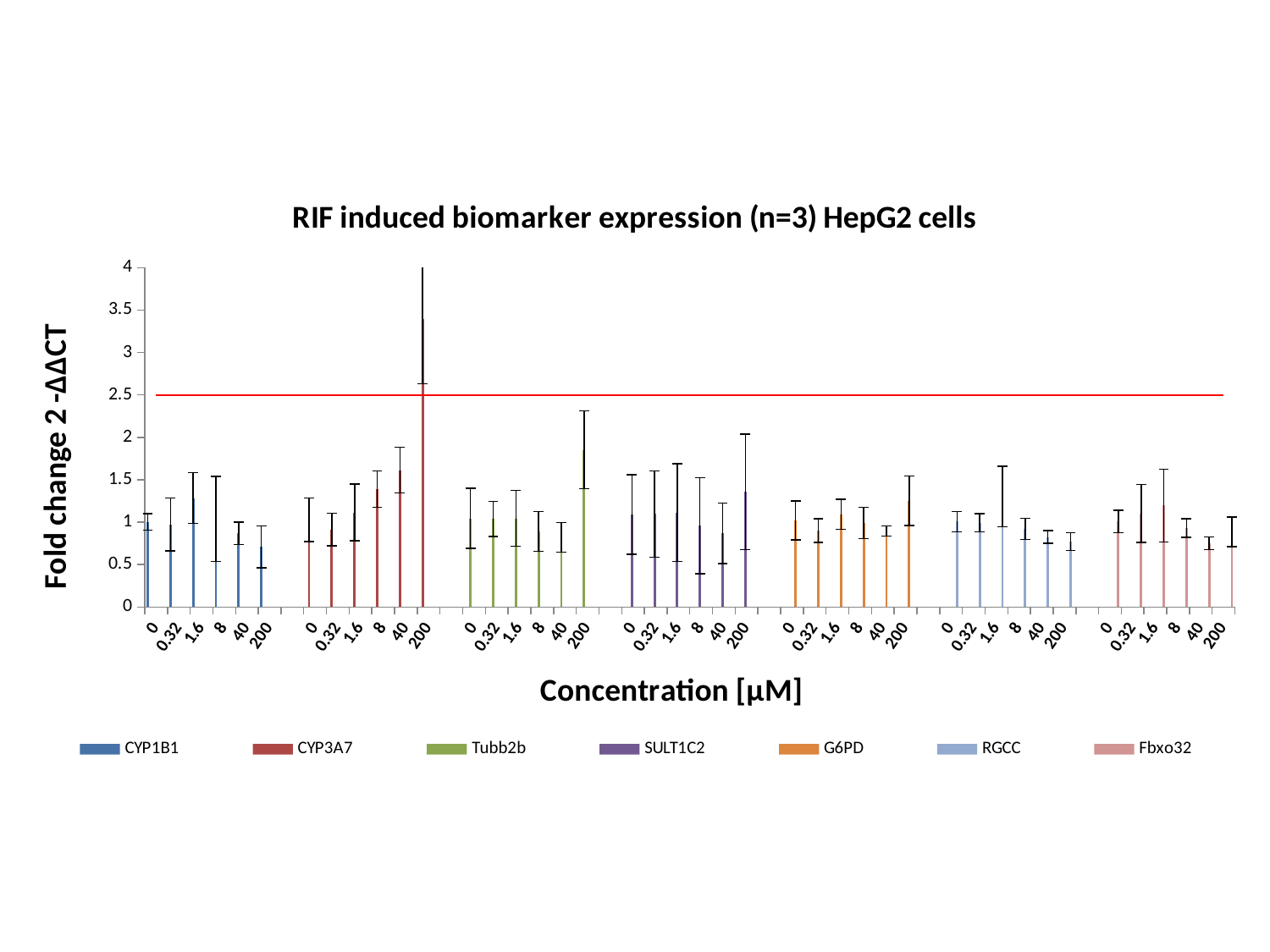
How many concentration categories are plotted for each series? 6 Is the value for CYP3A7 at 200 µM greater or less than 3? greater What is the title of the chart? RIF induced biomarker expression (n=3) HepG2 cells Which series and concentration has the highest fold change on the chart? CYP3A7 at 200 How many series does the legend list? 7 Is the value for RGCC at 200 µM greater or less than 1? less Is the value for CYP1B1 at 200 µM greater or less than 1? less At what y-axis value is the horizontal red line drawn? 2.5 What kind of chart is shown on the slide? bar chart Which is larger, the value for CYP3A7 at 200 µM or the value for CYP1B1 at 200 µM? CYP3A7 at 200 µM Do the CYP3A7 values rise or fall as concentration increases from 0 to 200 µM? rise